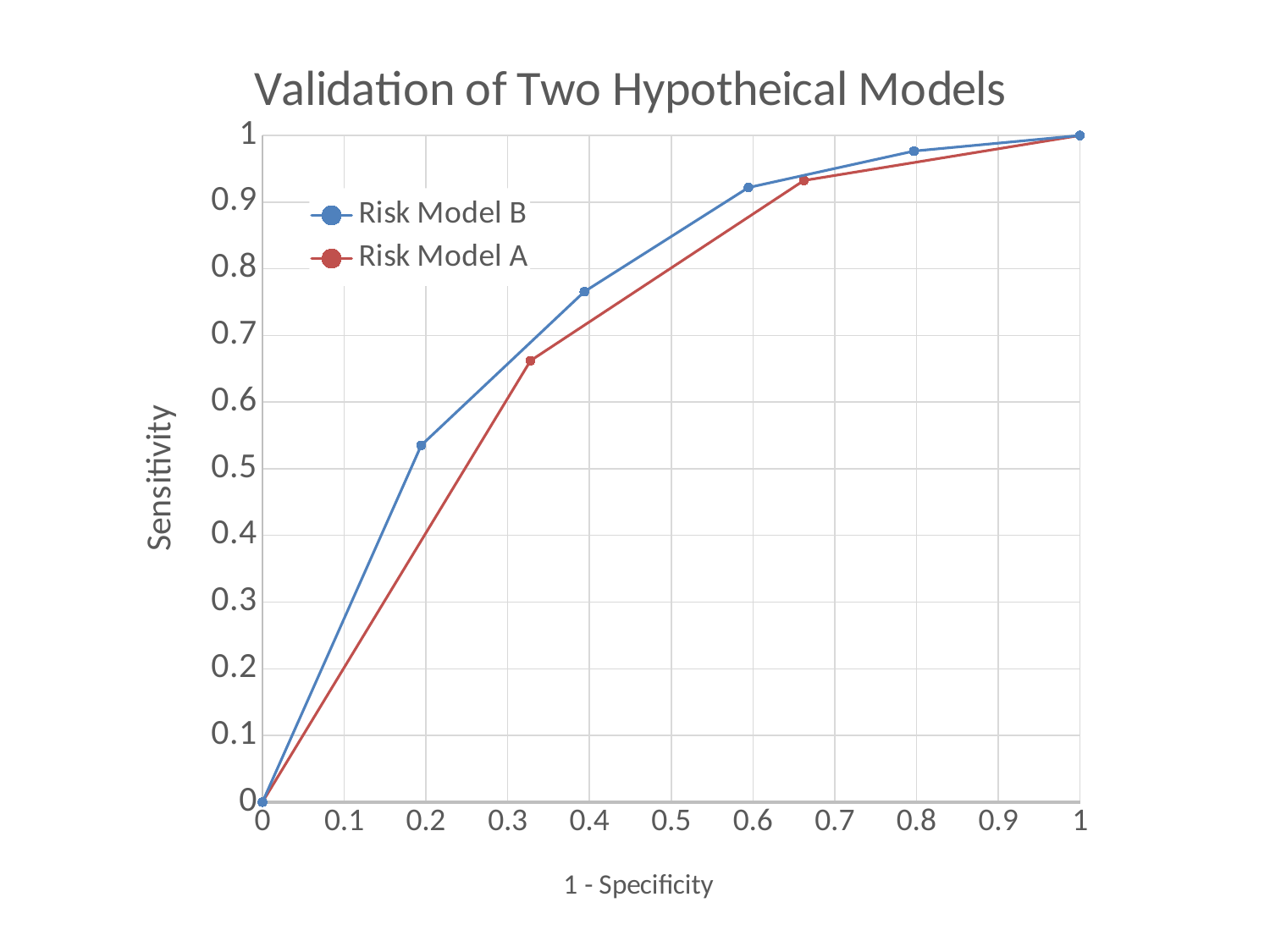
How many data points are plotted for Risk Model B? 6 How many series does the legend list? 2 What is the sensitivity of Risk Model B when 1 - Specificity is 1? 1 Is the sensitivity of Risk Model B at its second point (1 - Specificity near 0.2) greater or less than 0.5? greater What kind of chart is shown on the slide? line chart How many data points are plotted for Risk Model A? 4 What is the label of the y axis? Sensitivity What is the title of the chart? Validation of Two Hypotheical Models What is the sensitivity of Risk Model A when 1 - Specificity is 0? 0 Is the sensitivity of Risk Model A at its second point (1 - Specificity near 0.33) greater or less than 0.6? greater Does sensitivity rise or fall as 1 - Specificity increases for Risk Model A? rise Which series has the higher sensitivity when 1 - Specificity is around 0.4, Risk Model A or Risk Model B? Risk Model B